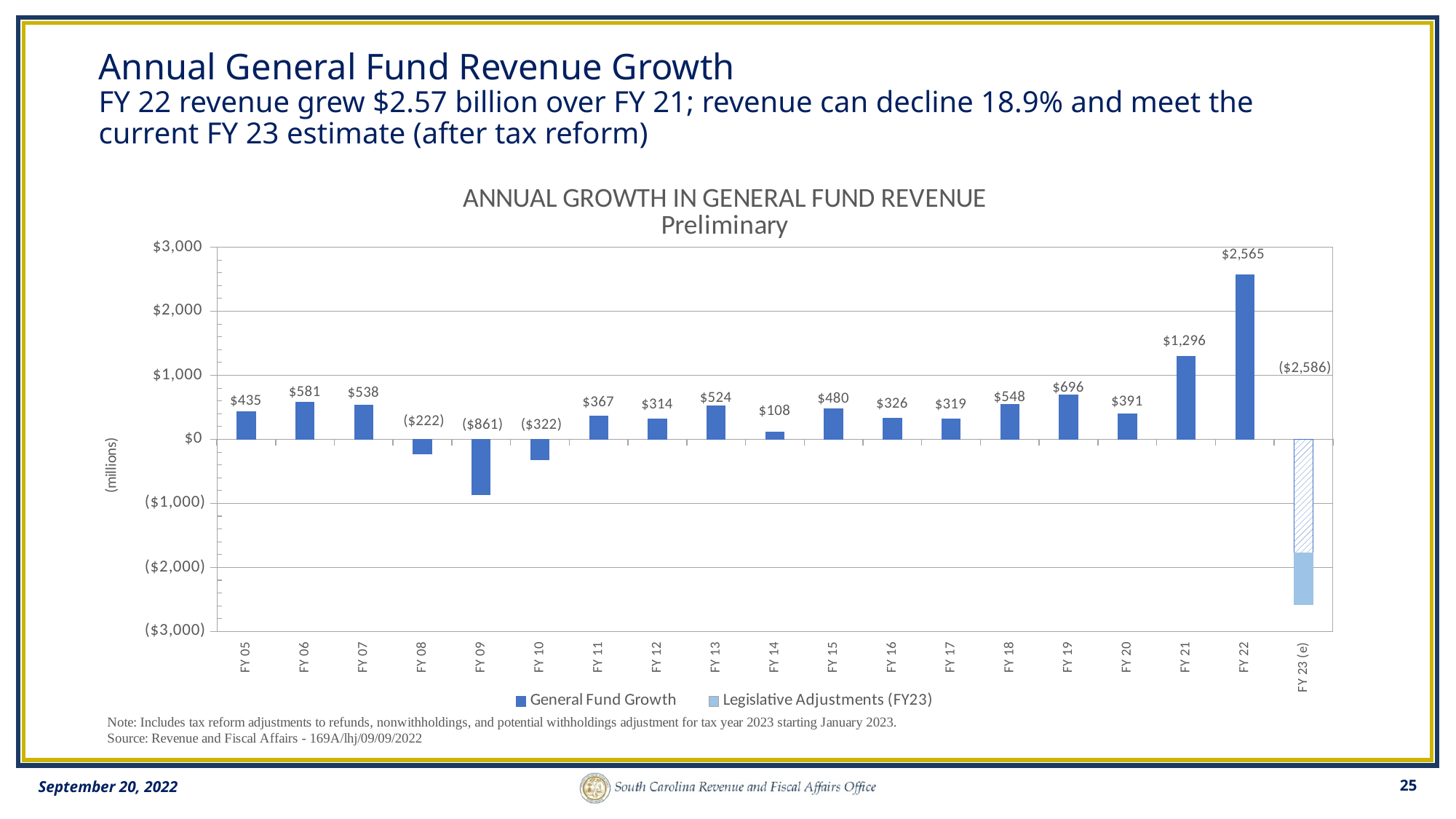
What is the difference between the FY 22 value and the FY 21 value? $1,269 Which is larger, the value for FY 06 or the value for FY 07? FY 06 How many fiscal years are shown on the x axis? 19 What kind of chart is shown on the slide? Bar chart What is the General Fund Growth value for FY 09? ($861) What is the value labeled for FY 23 (e)? ($2,586) Which fiscal year has the lowest value on the chart? FY 23 (e) Is the value for FY 21 greater or less than $1,000? greater How many series does the legend list? 2 What is the General Fund Growth value for FY 22? $2,565 What is the value shown for FY 14? $108 Which fiscal year has the highest General Fund Growth? FY 22